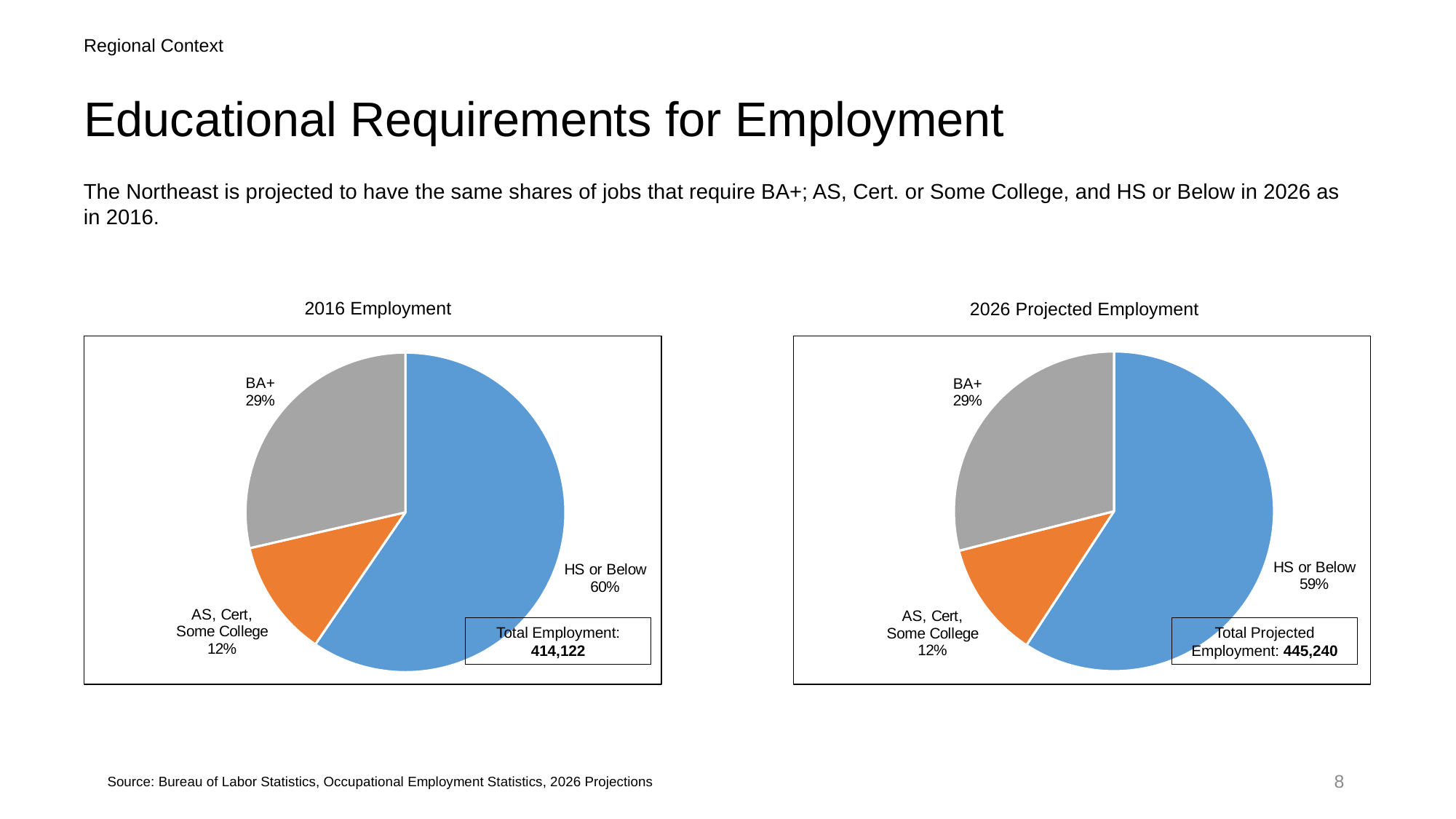
In the 2016 Employment chart, what share of jobs require HS or Below? 60% In the 2016 Employment chart, what share of jobs require BA+? 29% In the 2026 Projected Employment chart, which category has the smallest slice? AS, Cert, Some College In the 2026 Projected Employment chart, what share of jobs require HS or Below? 59% In the 2016 Employment chart, which category has the largest slice? HS or Below How many categories does the 2016 Employment chart show? 3 What kind of chart is the 2026 Projected Employment chart? Pie chart In the 2026 Projected Employment chart, which is larger: the BA+ share or the AS, Cert, Some College share? BA+ What total projected employment figure is shown in the 2026 Projected Employment chart? 445,240 What total employment figure is shown in the 2016 Employment chart? 414,122 In the 2016 Employment chart, how many percentage points larger is the HS or Below share than the BA+ share? 31